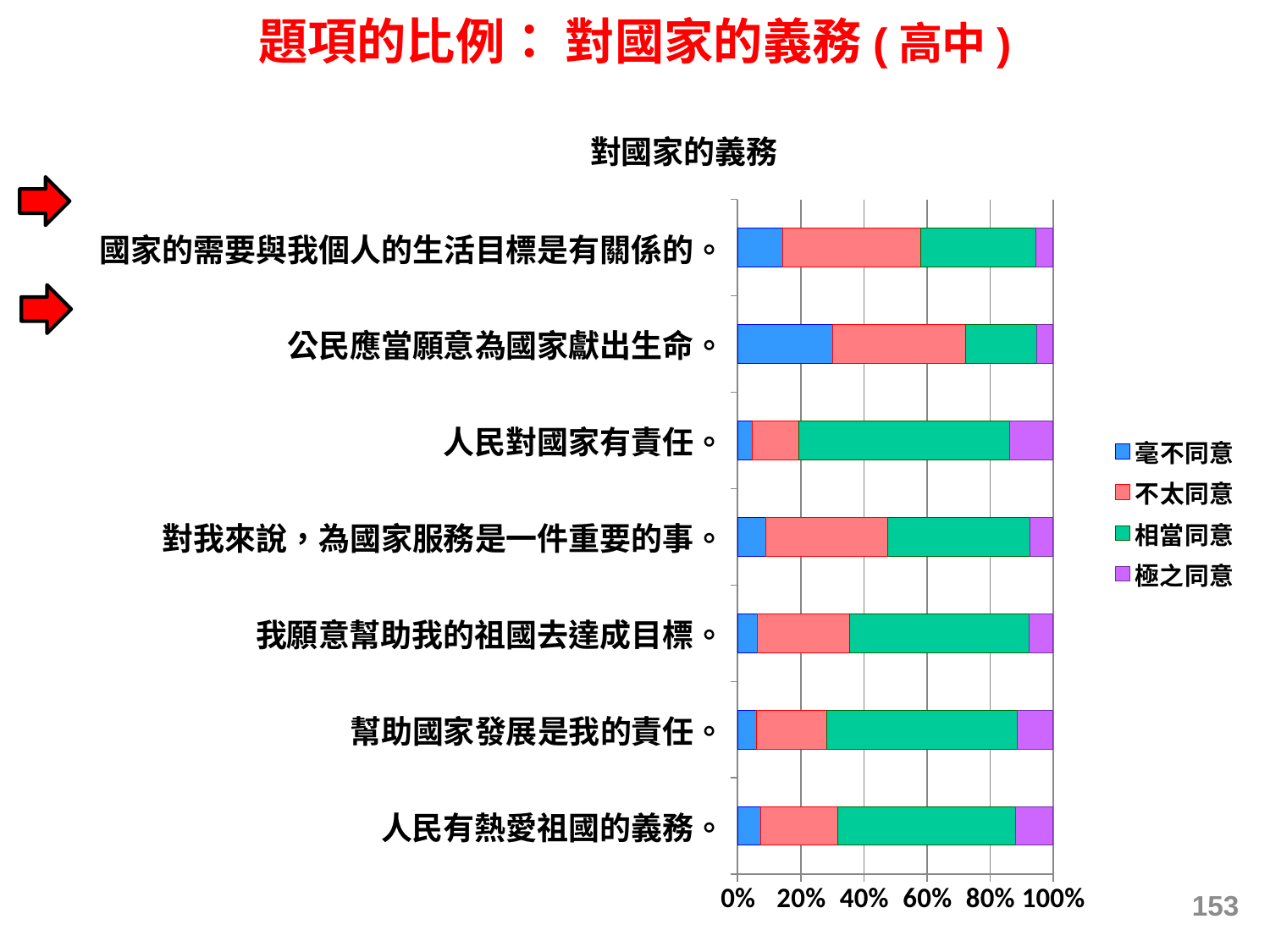
Which statement has the largest 毫不同意 share? 公民應當願意為國家獻出生命。 Is the 毫不同意 share for 公民應當願意為國家獻出生命 greater or less than 20%? greater Is the combined 毫不同意 and 不太同意 share for 公民應當願意為國家獻出生命 greater or less than 60%? greater What kind of chart is shown on the slide? Stacked bar chart How many statements (categories) are plotted in the chart? 7 Which legend entry is shown in green? 相當同意 Which has the larger 相當同意 share: 人民對國家有責任 or 公民應當願意為國家獻出生命? 人民對國家有責任。 How many series does the legend list? 4 Which statement has the largest 相當同意 share? 人民對國家有責任。 Which has the larger 毫不同意 share: 公民應當願意為國家獻出生命 or 國家的需要與我個人的生活目標是有關係的? 公民應當願意為國家獻出生命。 What is the title of the chart? 對國家的義務 Is the 極之同意 share for 公民應當願意為國家獻出生命 greater or less than 20%? less